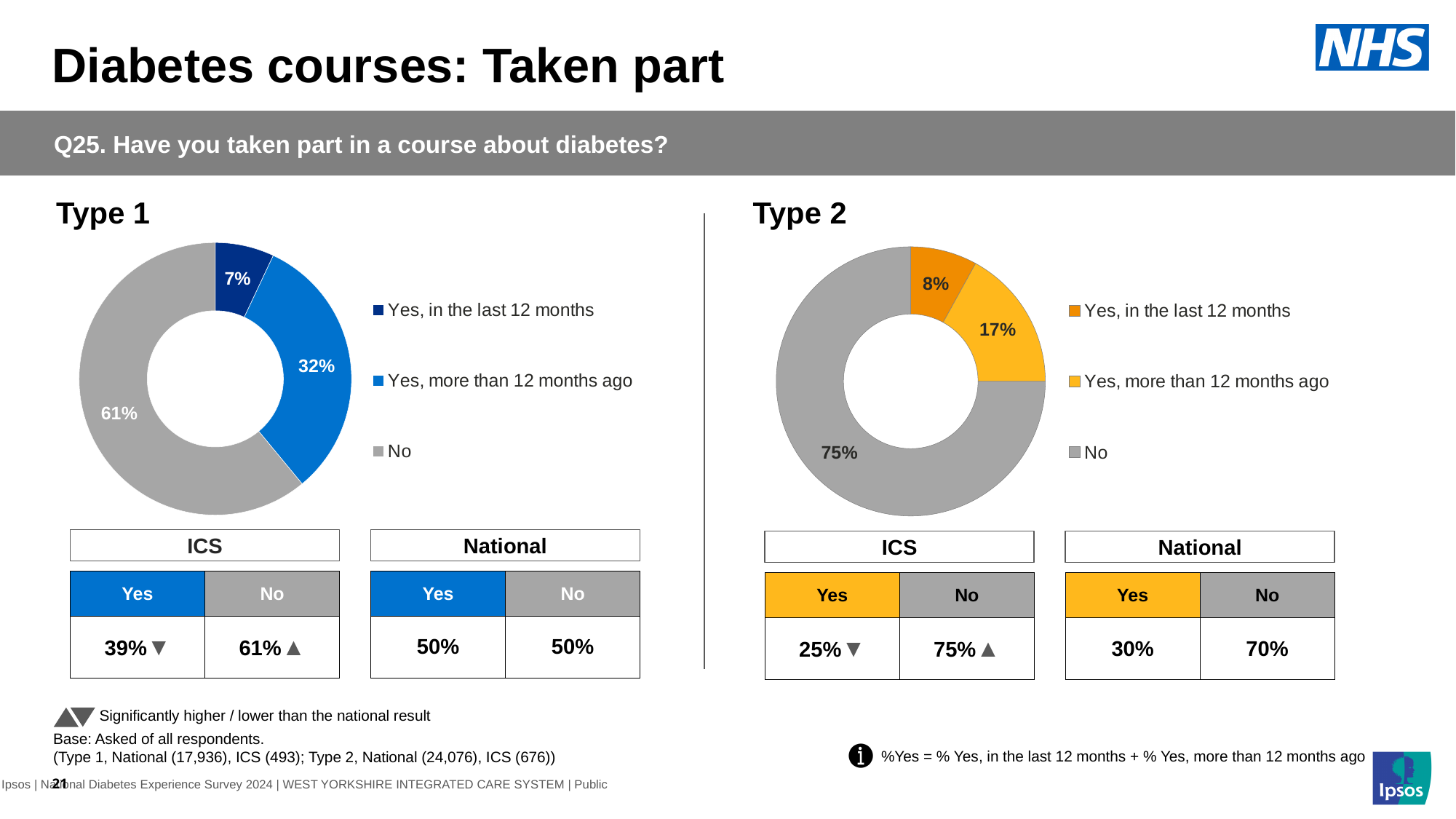
How many entries does the legend of the Type 2 chart list? 3 In the Type 2 chart, what percentage answered 'Yes, in the last 12 months'? 8% Which is larger: 'Yes, more than 12 months ago' in the Type 1 chart or in the Type 2 chart? Type 1 In the Type 1 chart, which category has the smallest share? Yes, in the last 12 months In the Type 1 chart, what percentage of respondents answered 'No'? 61% In the Type 2 chart, what colour is the 'No' segment? Grey How many categories does the Type 1 chart show? 3 In the Type 2 chart, what is the difference between 'Yes, more than 12 months ago' and 'Yes, in the last 12 months'? 9% In the Type 1 chart, what is the combined share of the two 'Yes' categories? 39% In the Type 2 chart, which category has the largest share? No What kind of chart is used for Type 2? Doughnut chart In the Type 1 chart, what percentage answered 'Yes, more than 12 months ago'? 32%